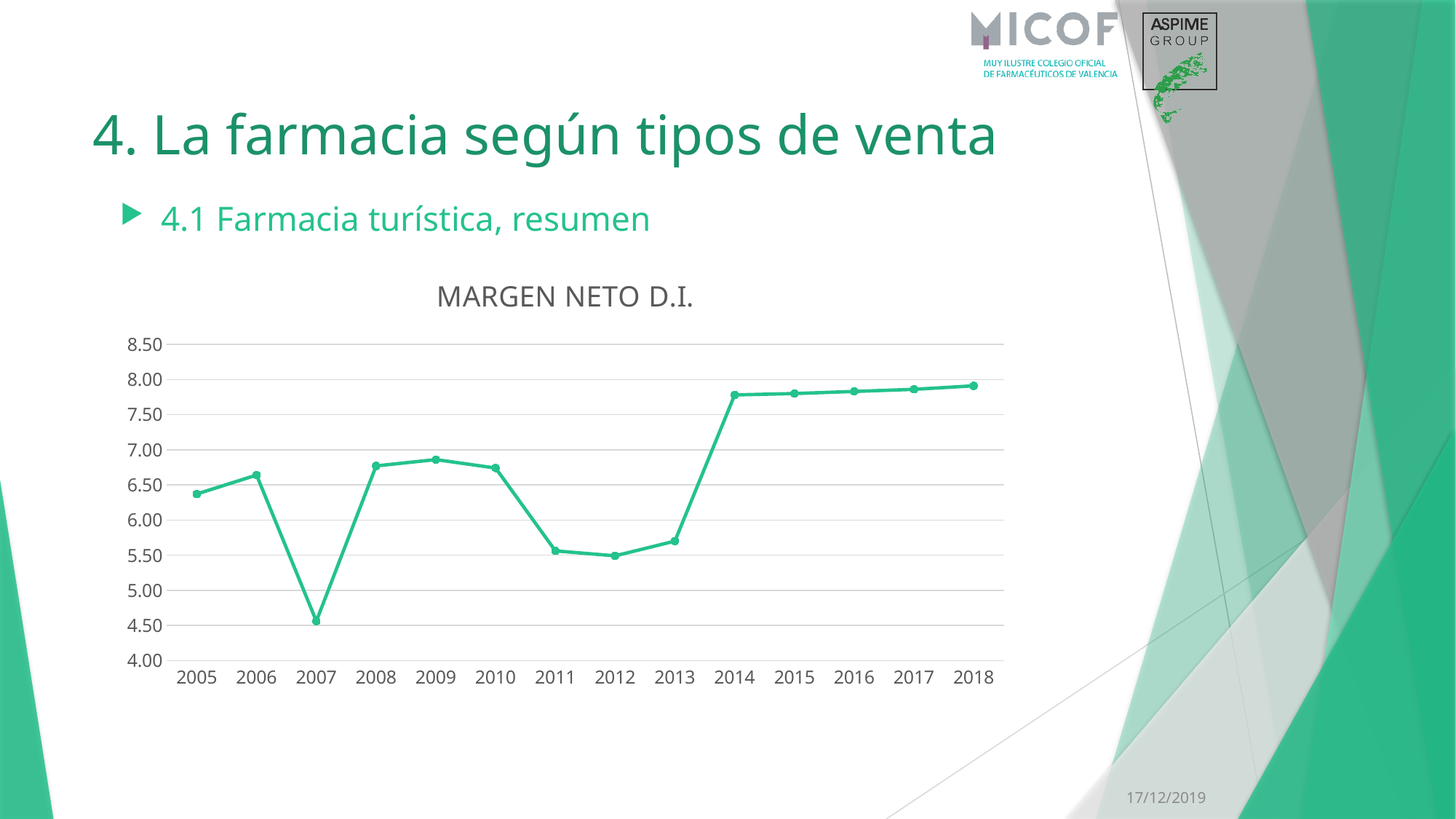
Do the values rise or fall from 2010 to 2012? fall Is the value for 2012 greater or less than 6.00? less What is the title of the chart? MARGEN NETO D.I. Which is larger, the value for 2008 or the value for 2011? 2008 What kind of chart is shown on the slide? line chart Is the value for 2007 greater or less than 5.00? less Is the value for 2009 greater or less than 6.50? greater Which year has the lowest value in the chart? 2007 Do the values rise or fall from 2014 to 2018? rise How many years are plotted on the x axis of the chart? 14 Which is larger, the value for 2013 or the value for 2014? 2014